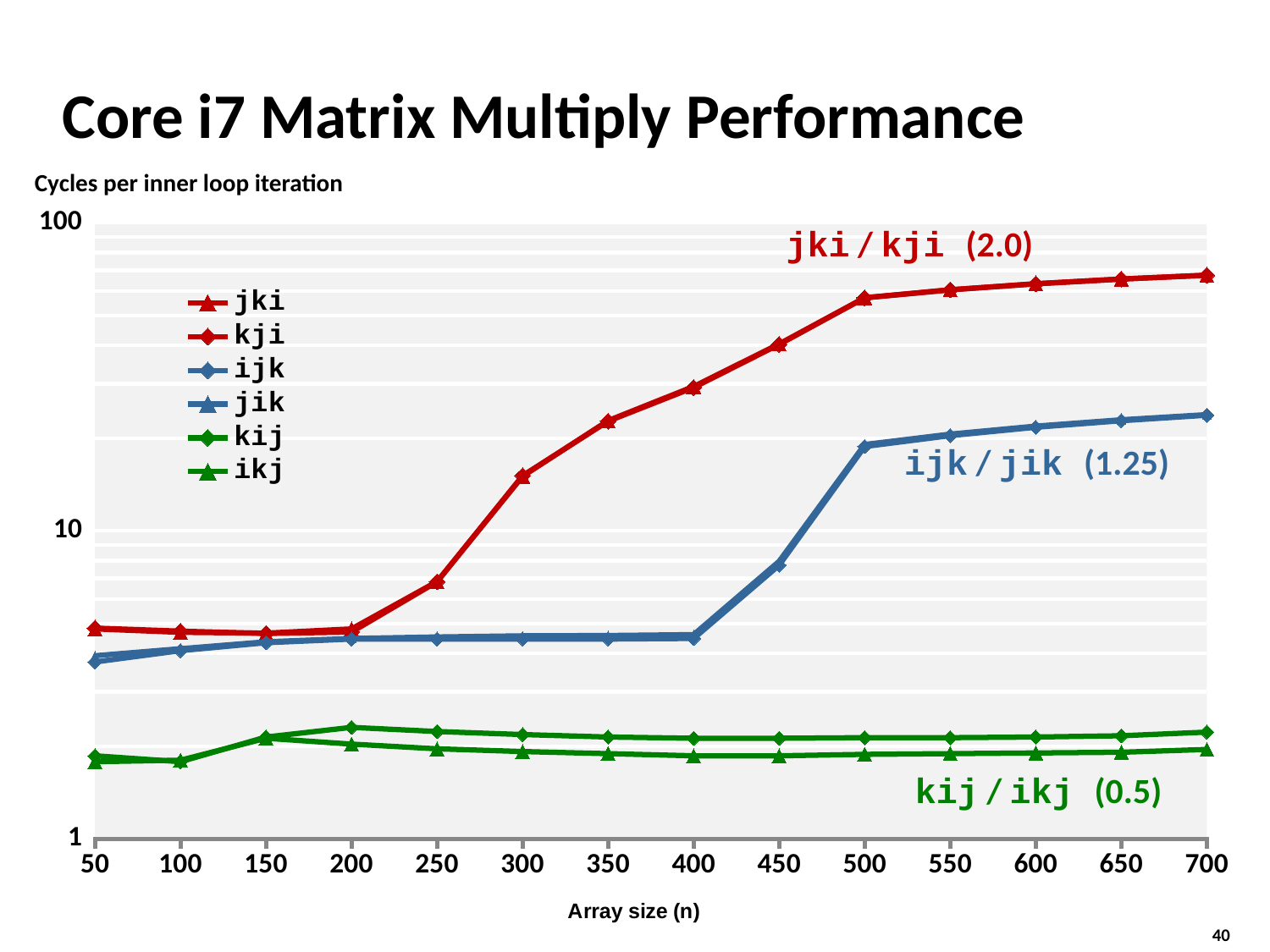
What is the label of the x axis? Array size (n) Is the value for jki at array size 700 greater or less than 10? greater Is the value for ijk at array size 300 greater or less than 10? less Is the value for kij at array size 500 greater or less than 10? less Do the values for jki rise or fall as the array size increases from 200 to 700? rise How many array sizes are plotted along the x axis? 14 How many series does the legend list? 6 What is the title of the chart? Core i7 Matrix Multiply Performance What kind of chart is shown on the slide? line chart At array size 500, which is larger, the value for jki or the value for ijk? jki At array size 600, which is larger, the value for ijk or the value for kij? ijk